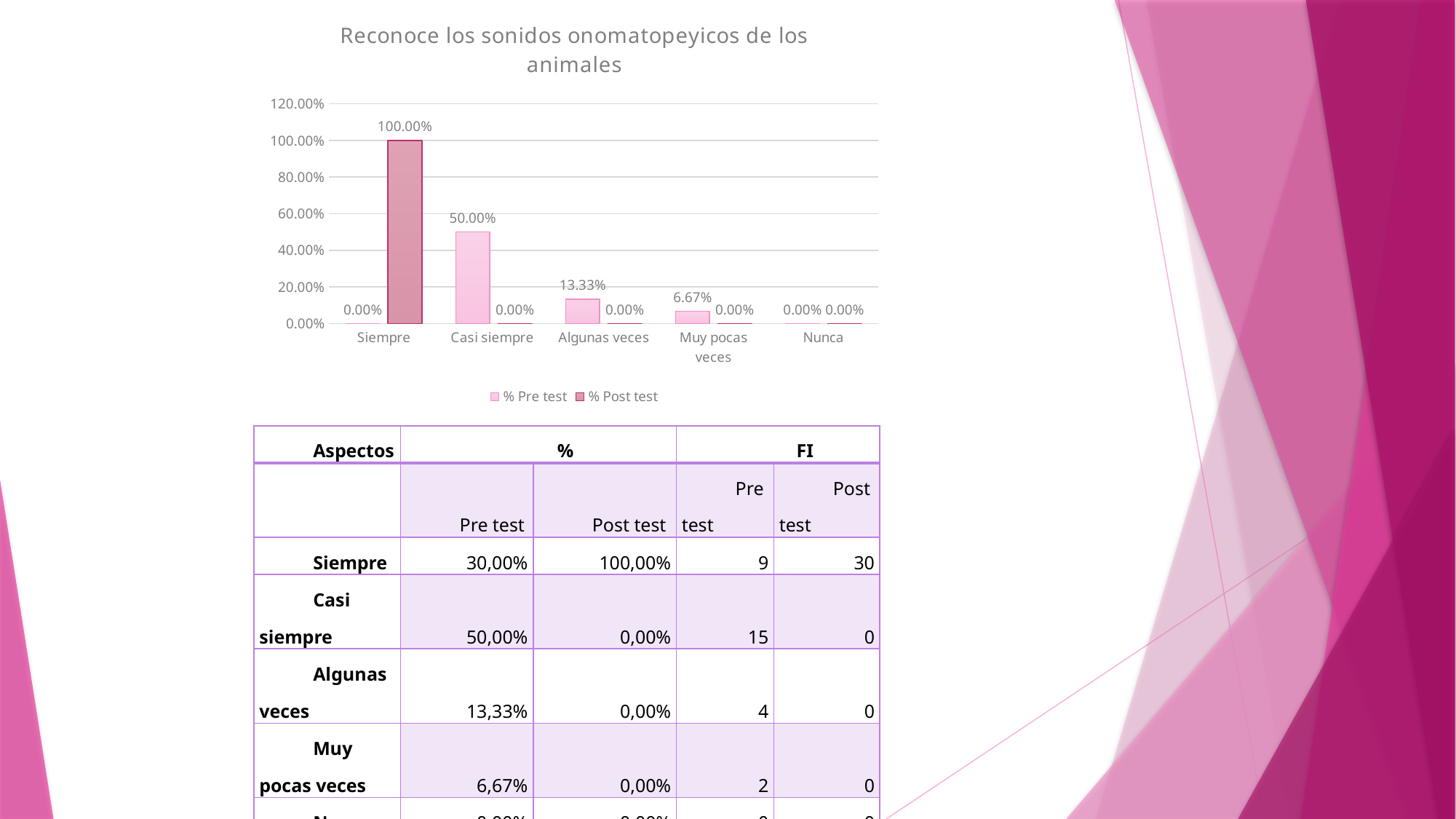
What is the % Post test value for Siempre in the chart? 100.00% What is the % Pre test value for Muy pocas veces in the chart? 6.67% How many categories are shown on the x axis of the chart? 5 Which category has the highest % Post test value in the chart? Siempre Which category has the highest % Pre test value in the chart? Casi siempre How many series does the chart legend list? 2 What is the difference between the % Pre test values for Casi siempre and Algunas veces in the chart? 36.67% Which is larger in the chart: the % Pre test value for Algunas veces or for Muy pocas veces? Algunas veces What type of chart is shown on the slide? bar chart What is the % Pre test value for Algunas veces in the chart? 13.33% What is the title of the chart? Reconoce los sonidos onomatopeyicos de los animales What is the % Pre test value for Casi siempre in the chart? 50.00%